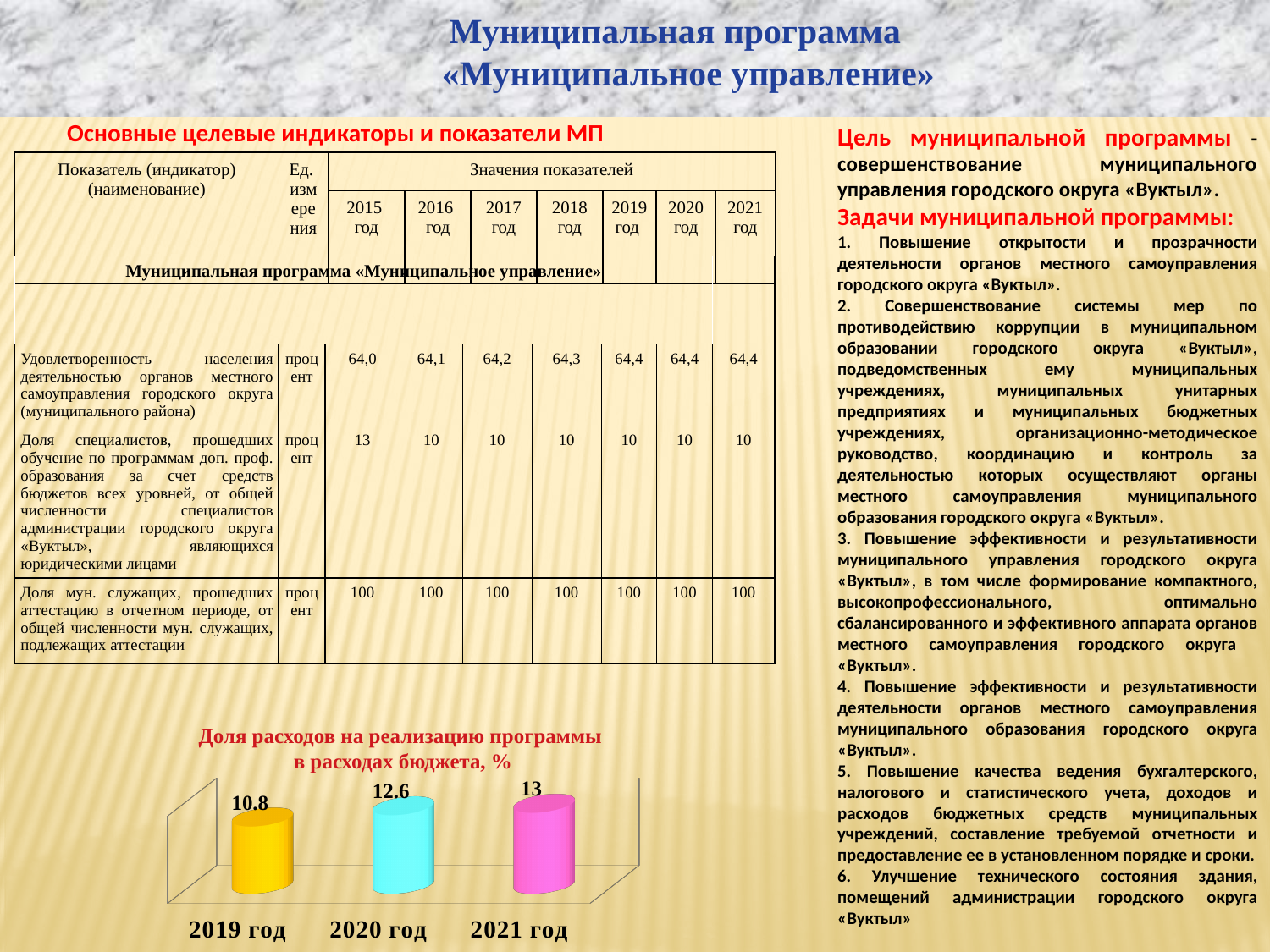
What is the value for 2019 год in the chart? 10.8 Which year has the lowest value in the chart? 2019 год What is the difference between the values for 2020 год and 2019 год? 1.8 What is the value for 2020 год in the chart? 12.6 How many categories are shown in the chart? 3 What is the title of the chart? Доля расходов на реализацию программы в расходах бюджета, % What is the difference between the values for 2021 год and 2019 год? 2.2 What is the value for 2021 год in the chart? 13 Which year has the highest value in the chart? 2021 год Do the values rise or fall from 2019 год to 2021 год? rise What kind of chart is shown on the slide? bar chart Which is larger, the value for 2020 год or the value for 2019 год? 2020 год